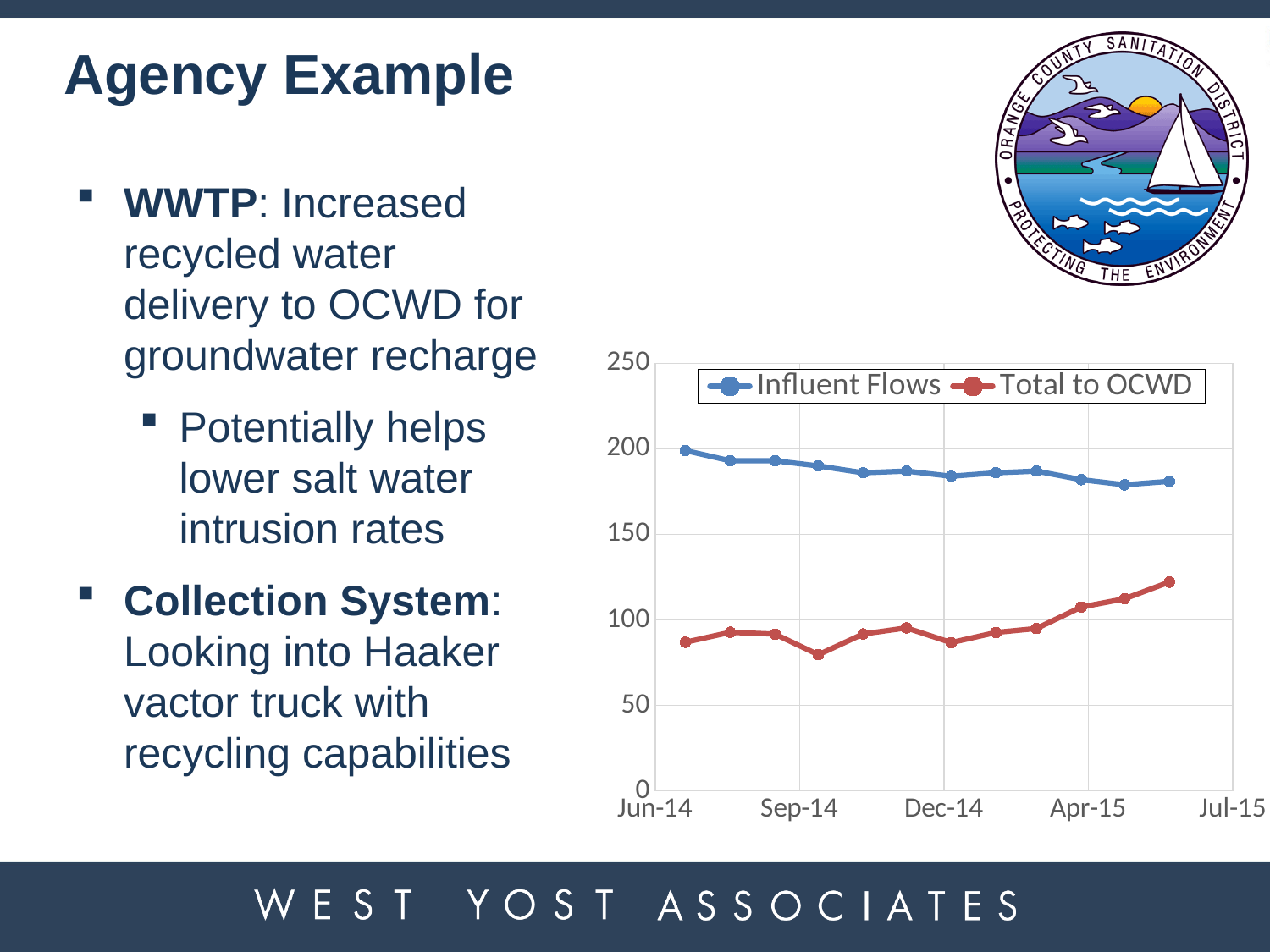
Is the last Influent Flows value (near Jul-15) greater or less than 150? greater Do the Total to OCWD values generally rise or fall over the period shown? rise How many series does the chart legend list? 2 Is the Influent Flows value at Dec-14 greater or less than 200? less Which colour is used for the Total to OCWD line? red Which series has higher values throughout the chart, Influent Flows or Total to OCWD? Influent Flows Is the first Total to OCWD value (near Jun-14) greater or less than 100? less Do the Influent Flows values generally rise or fall from Jun-14 to Jul-15? fall What kind of chart is shown on the slide? line chart How many data points are plotted for the Influent Flows series? 12 What are the two series named in the chart legend? Influent Flows and Total to OCWD